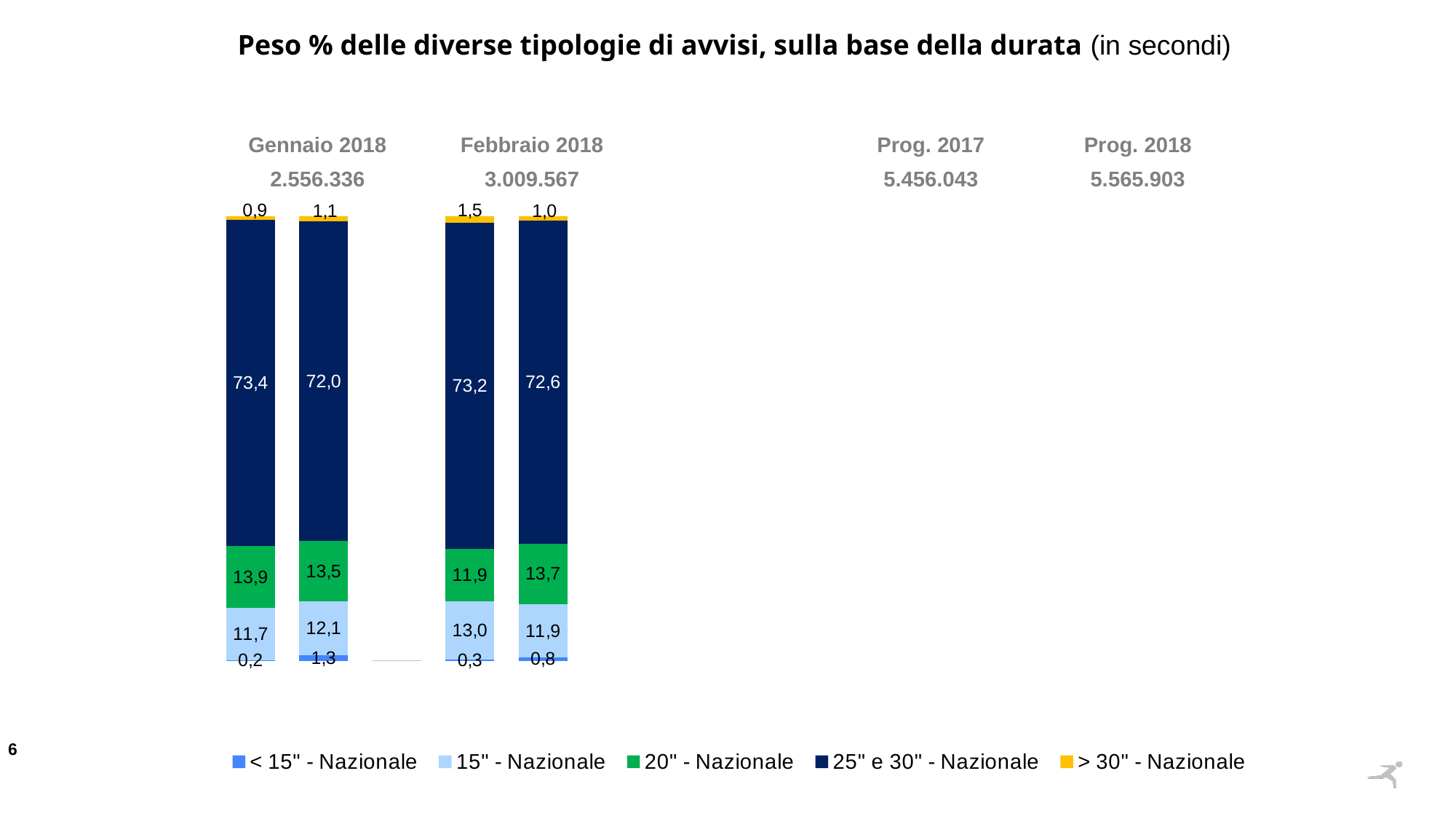
What is the value of the '> 30" - Nazionale' segment in the first (left) bar under Febbraio 2018? 1,5 What is the title of the chart? Peso % delle diverse tipologie di avvisi, sulla base della durata (in secondi) What is the value of the '20" - Nazionale' segment in the second (right) bar under Febbraio 2018? 13,7 What total figure is shown under the Febbraio 2018 heading? 3.009.567 How many series does the legend list? 5 What is the difference between the '25" e 30" - Nazionale' values of the two bars under Gennaio 2018 (73,4 and 72,0)? 1,4 What is the value of the '15" - Nazionale' segment in the first (left) bar under Febbraio 2018? 13,0 What is the value of the '< 15" - Nazionale' segment in the second (right) bar under Gennaio 2018? 1,3 What kind of chart is shown on the slide? Stacked bar chart Which series has the largest segment in every bar? 25" e 30" - Nazionale Which is larger: the '20" - Nazionale' value in the first bar under Gennaio 2018 or in the first bar under Febbraio 2018? First bar under Gennaio 2018 (13,9) What is the value of the '25" e 30" - Nazionale' segment in the first (left) bar under Gennaio 2018? 73,4